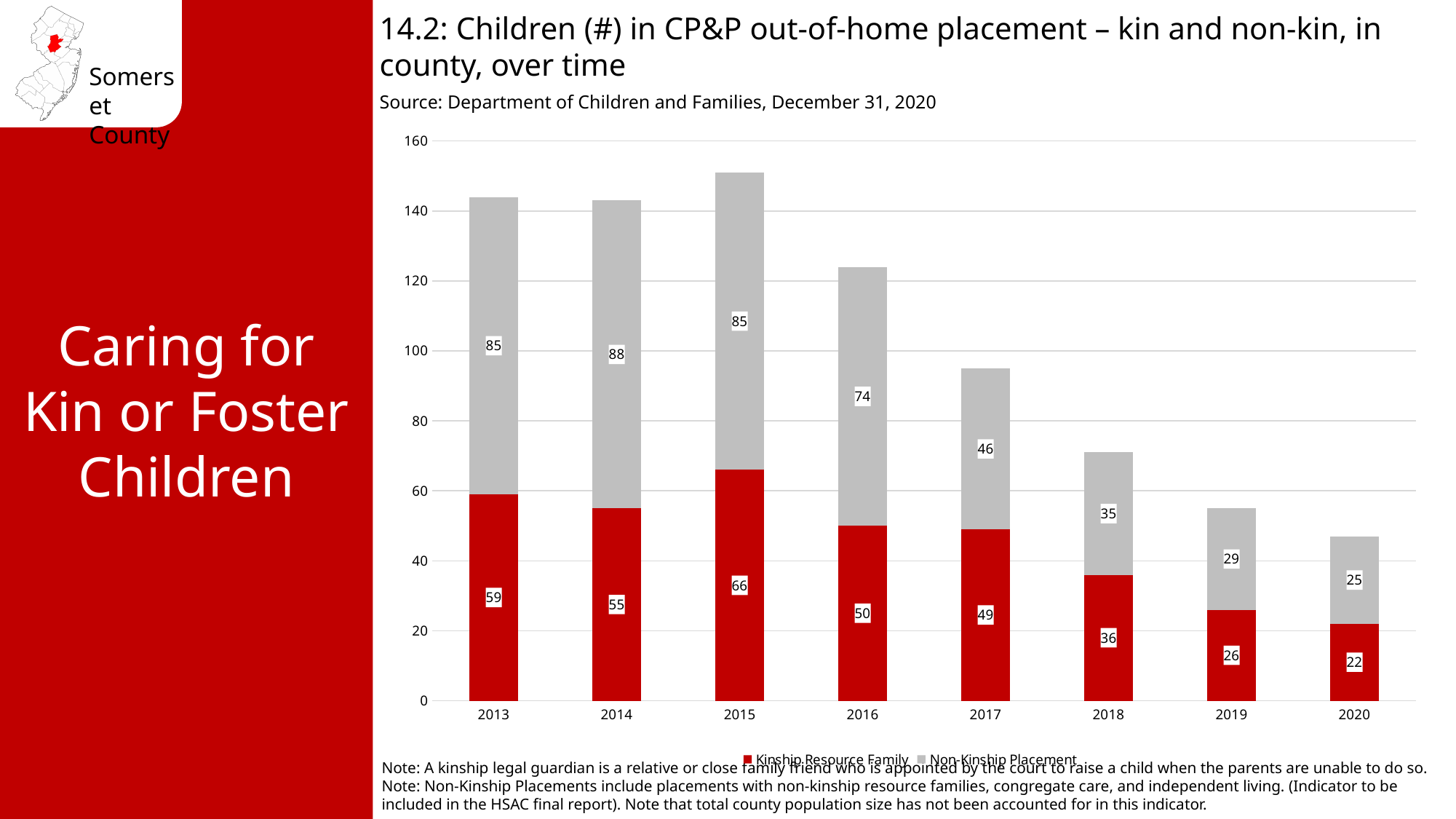
What is the difference between the Non-Kinship Placement values for 2013 and 2020? 60 What is the total of the stacked bar for 2020? 47 What is the Non-Kinship Placement value for 2016? 74 Which year has the lowest Kinship Resource Family value? 2020 Do the Kinship Resource Family values generally rise or fall from 2015 to 2020? Fall What is the total of the stacked bar for 2015? 151 Which year has the highest Non-Kinship Placement value? 2014 Which is larger in 2017, the Kinship Resource Family value or the Non-Kinship Placement value? Kinship Resource Family What kind of chart is shown on the slide? Stacked bar chart How many years are shown on the x axis? 8 How many series does the legend list? 2 What is the Kinship Resource Family value for 2015? 66